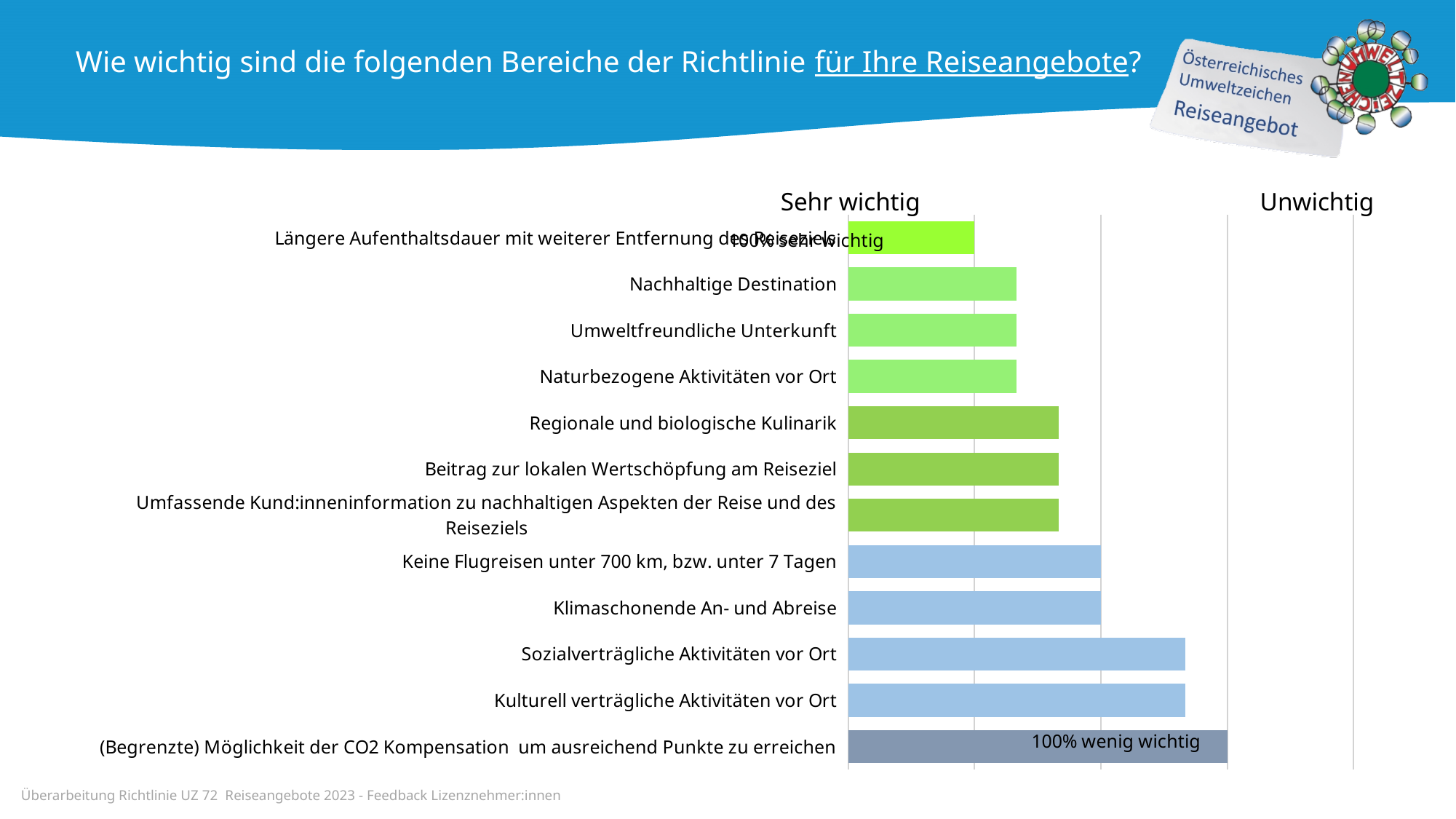
What data label is printed on the bar for 'Längere Aufenthaltsdauer mit weiterer Entfernung des Reiseziels'? 100% sehr wichtig Which bar is longer: 'Kulturell verträgliche Aktivitäten vor Ort' or 'Keine Flugreisen unter 700 km, bzw. unter 7 Tagen'? Kulturell verträgliche Aktivitäten vor Ort What label is shown at the right end of the chart's axis? Unwichtig Which bar is longer: 'Regionale und biologische Kulinarik' or 'Umweltfreundliche Unterkunft'? Regionale und biologische Kulinarik What label is shown at the left end of the chart's axis? Sehr wichtig Which bar is longer: 'Sozialverträgliche Aktivitäten vor Ort' or 'Nachhaltige Destination'? Sozialverträgliche Aktivitäten vor Ort What kind of chart is shown on the slide? bar chart Which category has the longest bar, i.e. is rated least important? (Begrenzte) Möglichkeit der CO2 Kompensation um ausreichend Punkte zu erreichen Going from the top category to the bottom category, do the bars generally get longer or shorter? longer How many categories (bars) does the chart show? 12 What data label is printed on the bar for '(Begrenzte) Möglichkeit der CO2 Kompensation um ausreichend Punkte zu erreichen'? 100% wenig wichtig Which category has the shortest bar, i.e. is rated most important? Längere Aufenthaltsdauer mit weiterer Entfernung des Reiseziels